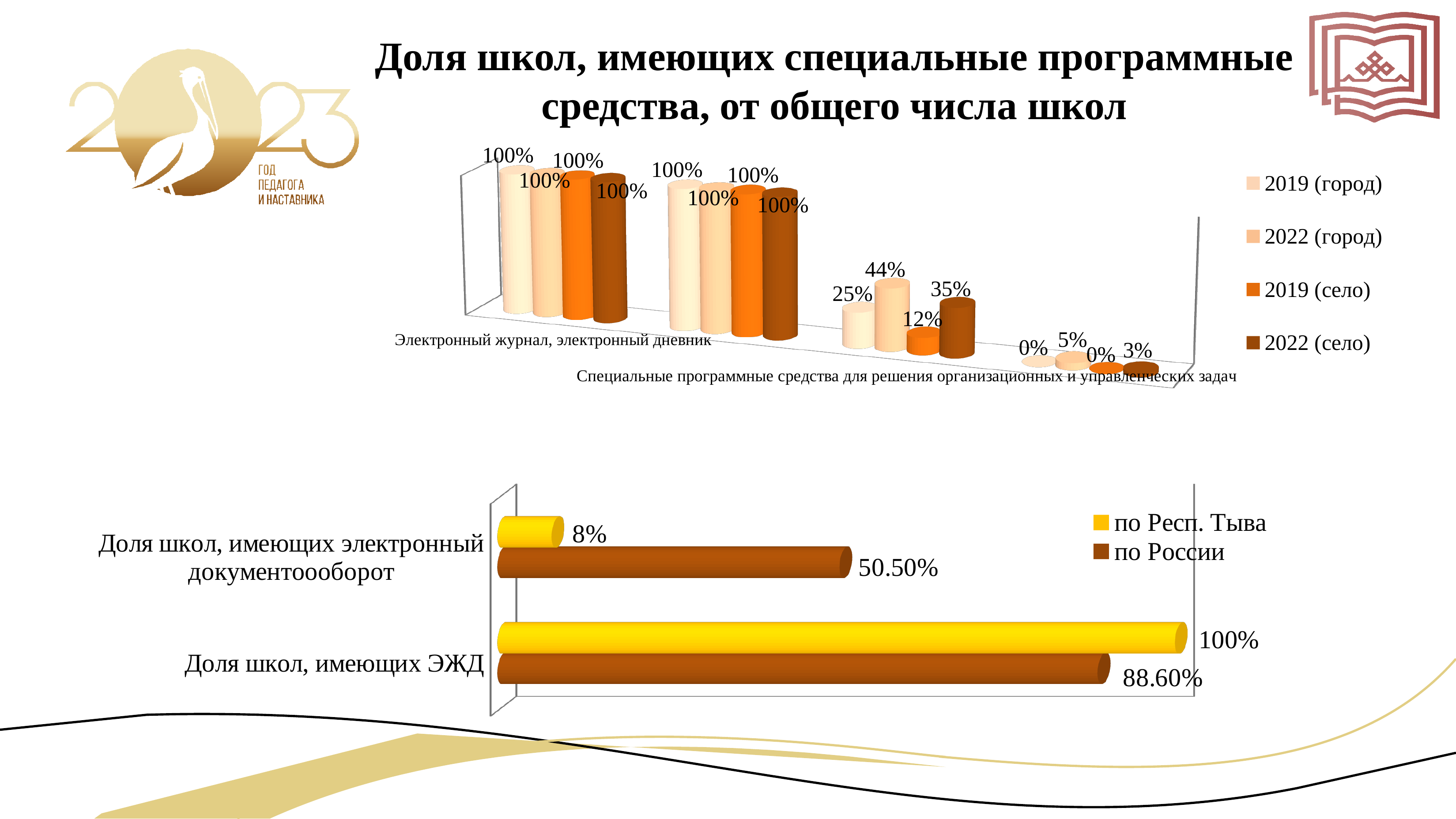
In the bottom chart, what is the value for по России for Доля школ, имеющих ЭЖД? 88.60% In the bottom chart, what is the difference between по Респ. Тыва and по России for Доля школ, имеющих ЭЖД? 11.4% In the top chart, how many groups of bars are plotted? 4 In the top chart, how many series does the legend list? 4 What kind of chart is the bottom chart? Bar chart In the bottom chart, what is the value for по Респ. Тыва for Доля школ, имеющих электронный документооборот? 8% In the bottom chart, what is the value for по России for Доля школ, имеющих электронный документооборот? 50.50% In the bottom chart, which is larger for Доля школ, имеющих ЭЖД: по Респ. Тыва or по России? по Респ. Тыва In the bottom chart, how many series does the legend list? 2 In the top chart, what are the legend entries? 2019 (город), 2022 (город), 2019 (село), 2022 (село) In the bottom chart, what is the value for по Респ. Тыва for Доля школ, имеющих ЭЖД? 100% In the bottom chart, what is the difference between по России and по Респ. Тыва for Доля школ, имеющих электронный документооборот? 42.5%